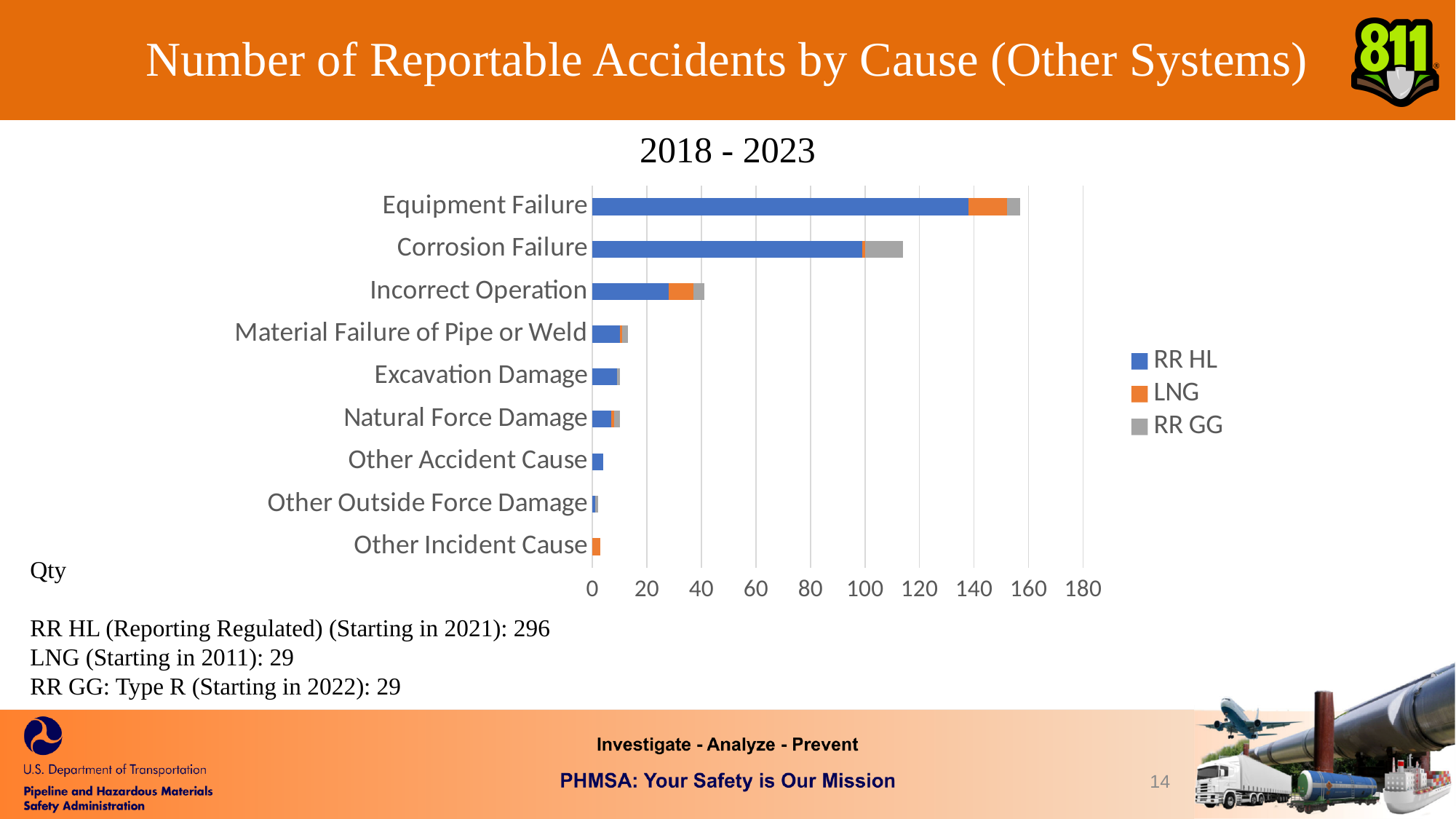
Which has the longer total bar, Incorrect Operation or Excavation Damage? Incorrect Operation Is the total bar for Corrosion Failure greater or less than 100? greater Which cause category has the longest total bar? Equipment Failure What are the three series listed in the chart legend? RR HL, LNG, RR GG Is the total bar for Equipment Failure greater or less than 140? greater How many series does the chart legend list? 3 Is the total bar for Material Failure of Pipe or Weld greater or less than 20? less How many cause categories are plotted on the chart? 9 Which has the longer total bar, Equipment Failure or Corrosion Failure? Equipment Failure What period does the chart title above the plot area indicate? 2018 - 2023 What kind of chart is shown on the slide? Stacked bar chart